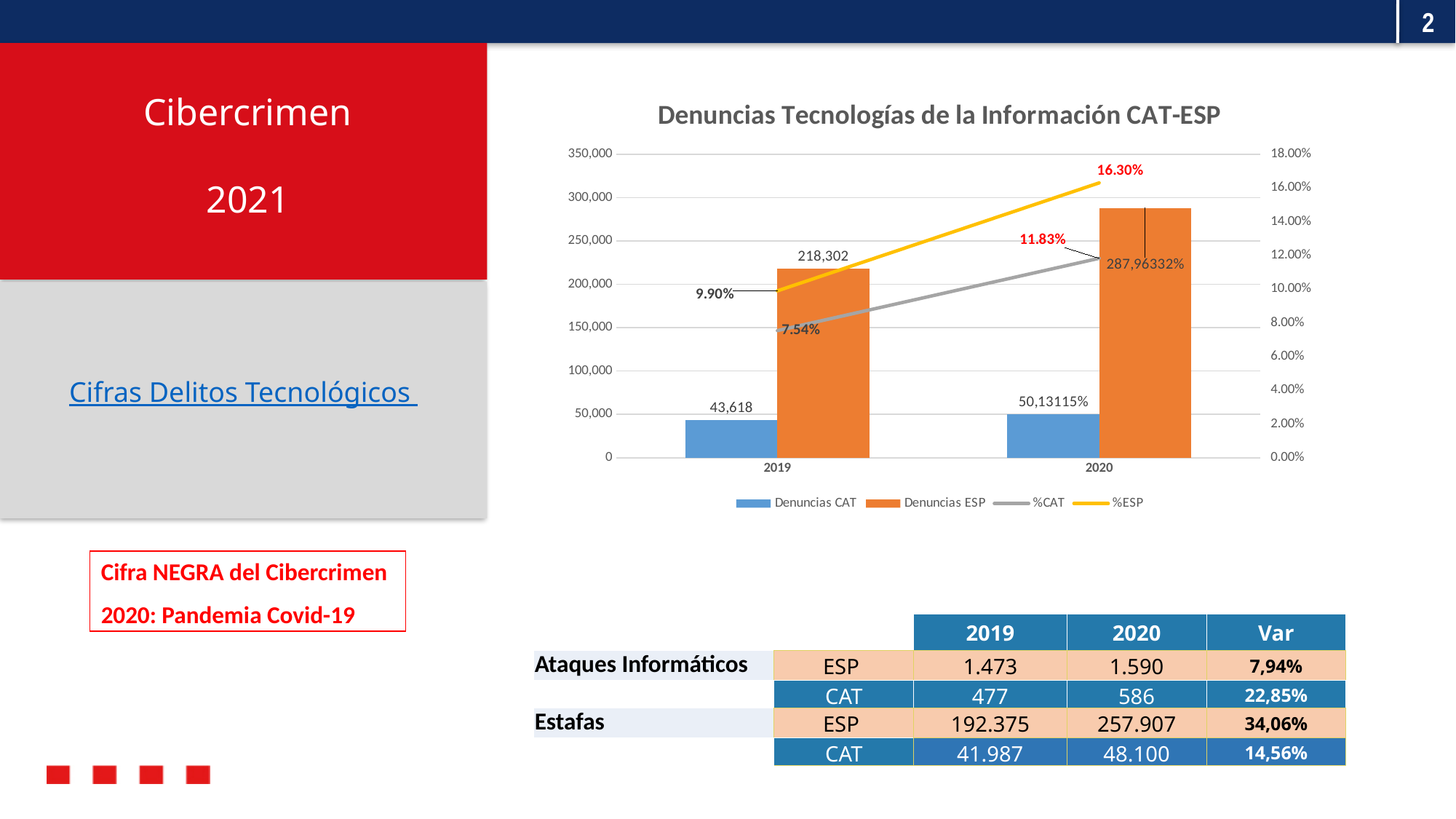
What is the difference between Denuncias ESP and Denuncias CAT in 2019? 174,684 What is the value of Denuncias ESP for 2019? 218,302 How many series does the legend list? 4 Which is larger in 2019, Denuncias ESP or Denuncias CAT? Denuncias ESP What is the %CAT value for 2020? 11.83% How many years are shown on the x axis? 2 What is the %ESP value for 2019? 9.90% What is the %ESP value for 2020? 16.30% What is the %CAT value for 2019? 7.54% Is the value for Denuncias ESP in 2020 greater or less than 250,000? greater Does the %ESP line rise or fall from 2019 to 2020? rise What is the value of Denuncias CAT for 2019? 43,618